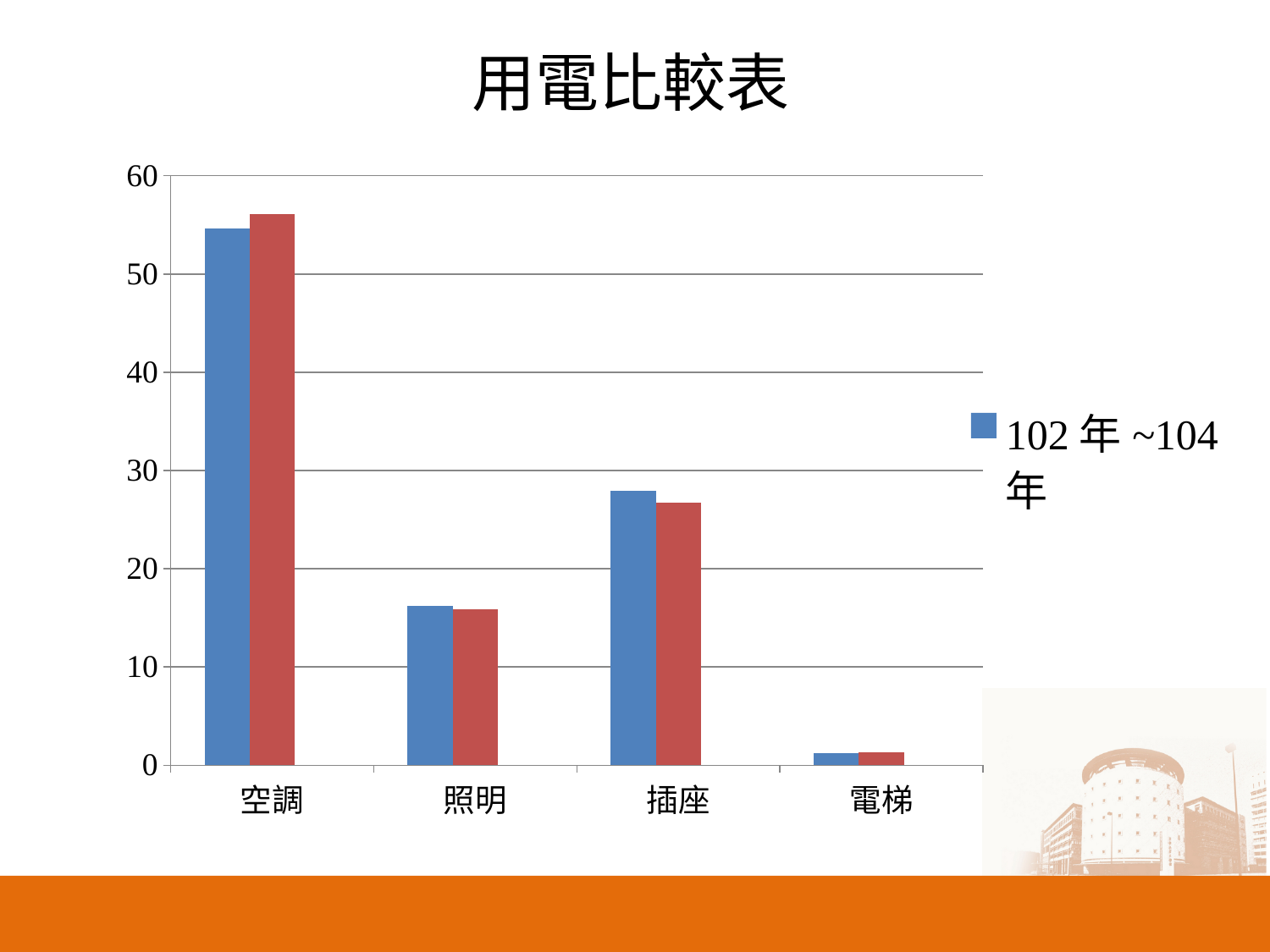
How many entries does the chart's legend list? 1 Which category has larger values, 照明 or 電梯? 照明 Is the value of the blue bar for 照明 greater or less than 20? less Is the value of the blue bar for 空調 greater or less than 50? greater Is the value of the red bar for 電梯 greater or less than 10? less Which category has the lowest values in the chart? 電梯 How many categories are shown on the x axis of the chart? 4 What kind of chart is shown on the slide? bar chart Which category has the highest values in the chart? 空調 Which category has larger values, 空調 or 插座? 空調 What is the title of the chart? 用電比較表